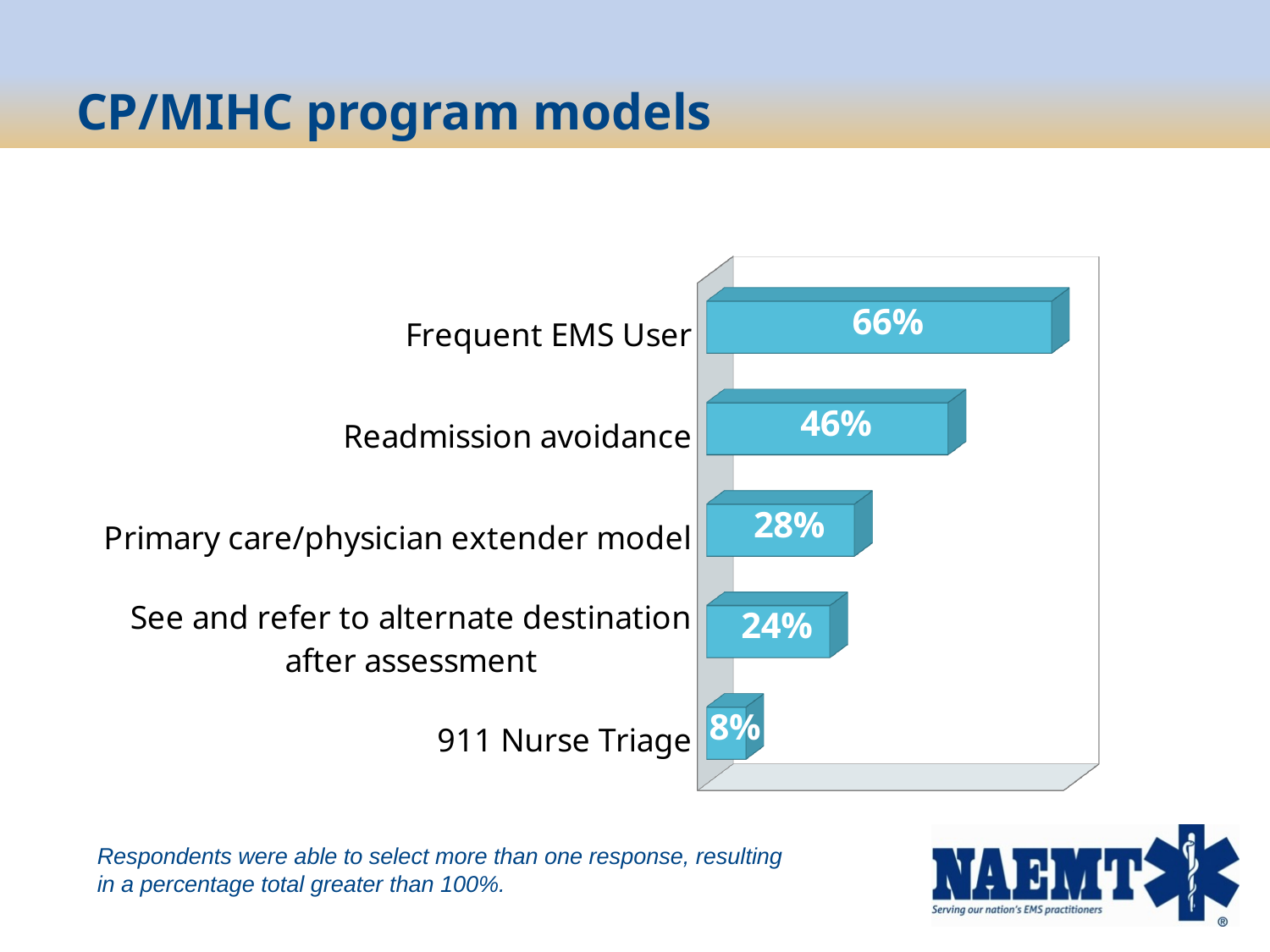
What percentage is shown for Primary care/physician extender model? 28% How many program models are shown in the chart? 5 Which program model has the highest percentage? Frequent EMS User Which program model has the lowest percentage? 911 Nurse Triage What kind of chart is shown on the slide? Bar chart Which is larger, the value for Primary care/physician extender model or the value for See and refer to alternate destination after assessment? Primary care/physician extender model What percentage is shown for 911 Nurse Triage? 8% What percentage is shown for Readmission avoidance? 46% What is the title of the slide containing the chart? CP/MIHC program models What percentage is shown for Frequent EMS User? 66% What percentage is shown for See and refer to alternate destination after assessment? 24% What is the difference in percentage points between Frequent EMS User and Readmission avoidance? 20